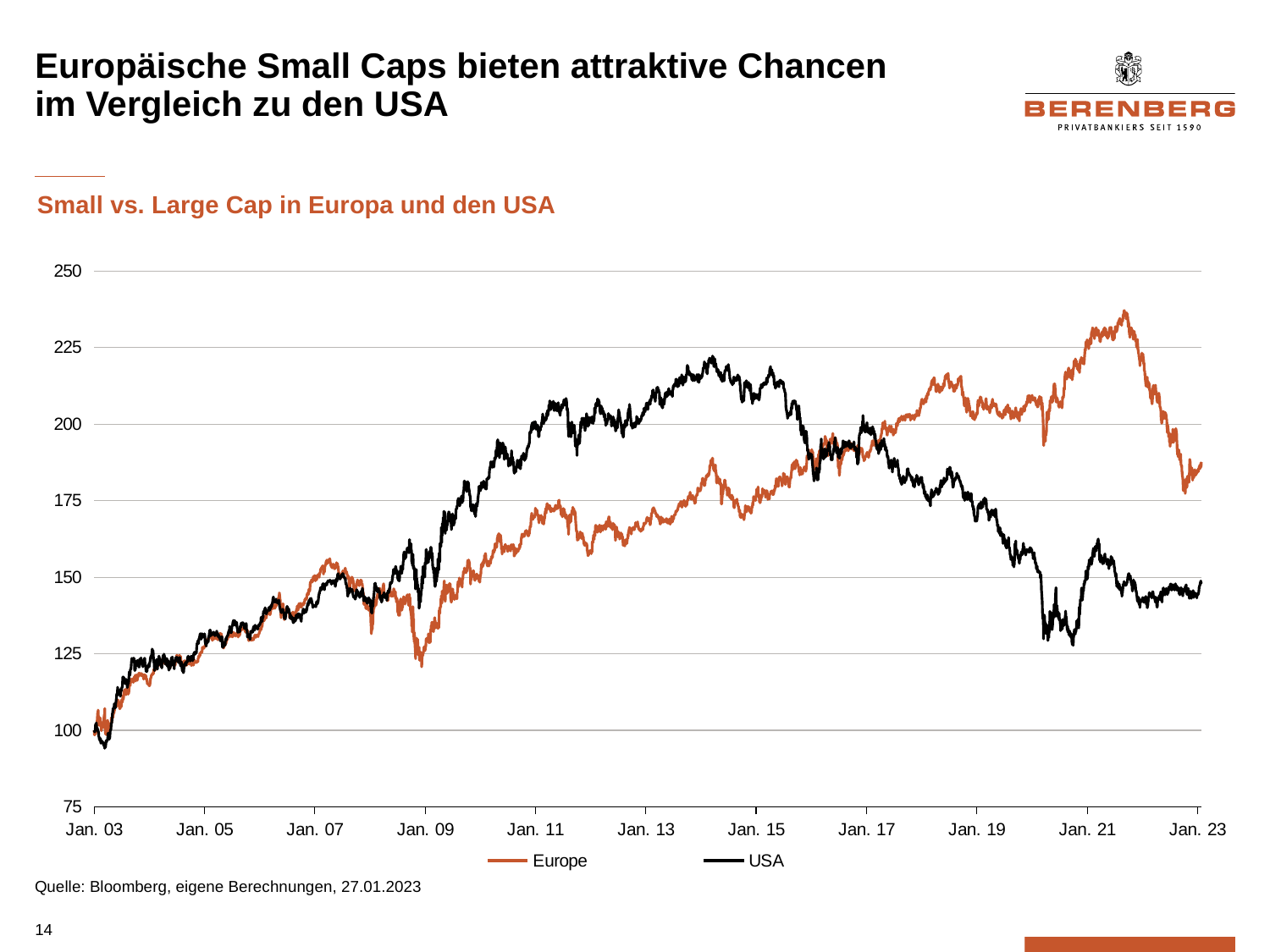
At Jan. 23, which series has the higher value, Europe or USA? Europe Is the highest value reached by the Europe series greater or less than 225? greater How many labelled tick marks are on the x axis? 11 Is the value for USA at Jan. 23 greater or less than 175? less Which series reaches the highest value anywhere on the chart? Europe Does the USA series rise or fall overall between Jan. 19 and Jan. 23? fall Which colour is used for the USA series? black What is the title of the chart? Small vs. Large Cap in Europa und den USA At Jan. 13, which series has the higher value, Europe or USA? USA Is the value for Europe at Jan. 23 greater or less than 175? greater How many series does the legend list? 2 What kind of chart is shown on the slide? line chart